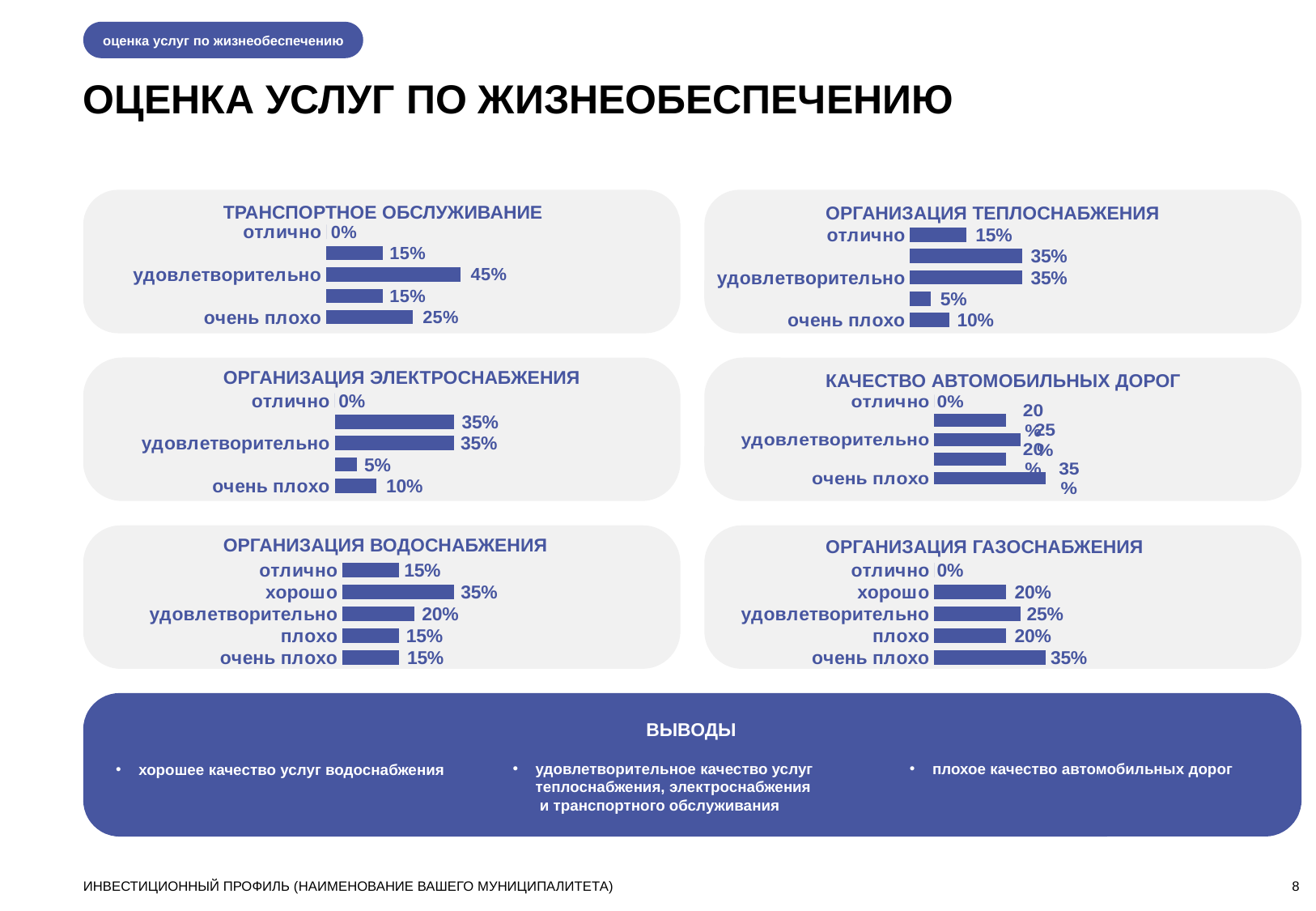
In the 'ОРГАНИЗАЦИЯ ЭЛЕКТРОСНАБЖЕНИЯ' chart, what is the value for 'очень плохо'? 10% How many categories does the 'ОРГАНИЗАЦИЯ ВОДОСНАБЖЕНИЯ' chart show? 5 In the 'ТРАНСПОРТНОЕ ОБСЛУЖИВАНИЕ' chart, what is the value for 'удовлетворительно'? 45% In the 'ОРГАНИЗАЦИЯ ГАЗОСНАБЖЕНИЯ' chart, what is the difference between 'очень плохо' and 'хорошо'? 15% In the 'ОРГАНИЗАЦИЯ ВОДОСНАБЖЕНИЯ' chart, which category has the highest value? хорошо In the 'КАЧЕСТВО АВТОМОБИЛЬНЫХ ДОРОГ' chart, what is the value for 'очень плохо'? 35% In the 'ТРАНСПОРТНОЕ ОБСЛУЖИВАНИЕ' chart, what is the value for 'очень плохо'? 25% In the 'ОРГАНИЗАЦИЯ ВОДОСНАБЖЕНИЯ' chart, what is the difference between 'отлично' and 'хорошо'? 20% In the 'ОРГАНИЗАЦИЯ ТЕПЛОСНАБЖЕНИЯ' chart, what is the value for 'отлично'? 15% In the 'ОРГАНИЗАЦИЯ ГАЗОСНАБЖЕНИЯ' chart, which category has the highest value? очень плохо In the 'ОРГАНИЗАЦИЯ ВОДОСНАБЖЕНИЯ' chart, which is larger: 'хорошо' or 'удовлетворительно'? хорошо What type of chart is 'ОРГАНИЗАЦИЯ ГАЗОСНАБЖЕНИЯ'? Bar chart